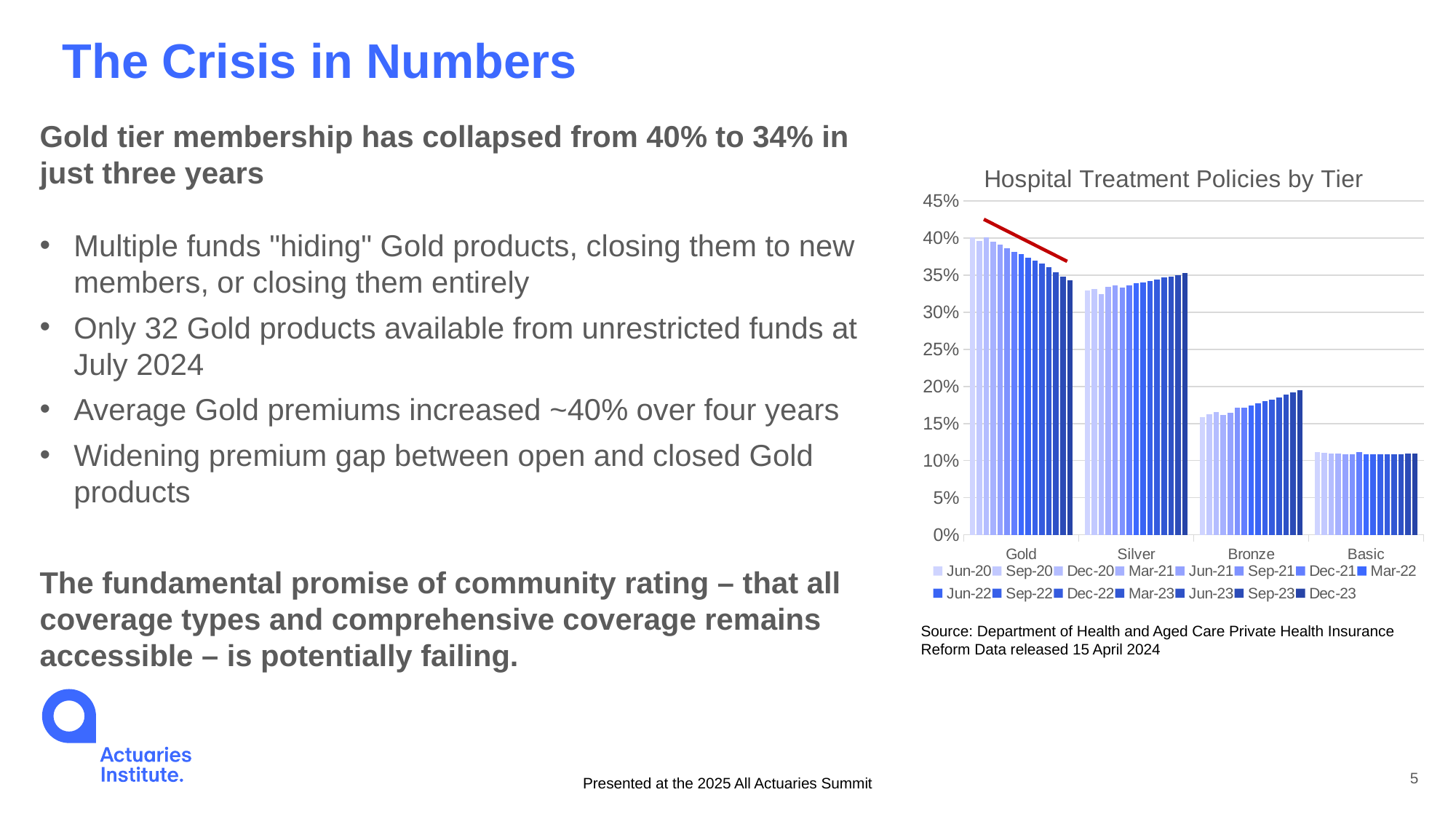
Which tier has the lowest share of hospital treatment policies in the chart? Basic Is the Gold tier value for Dec-23 greater or less than 40%? less How many tier categories are shown on the x axis of the chart? 4 Which is larger in Jun-20: the Gold tier value or the Silver tier value? Gold What is the title of the chart? Hospital Treatment Policies by Tier Is the Basic tier value for Dec-23 greater or less than 15%? less Is the Silver tier value for Dec-23 greater or less than 30%? greater Do the Bronze tier bars rise or fall from Jun-20 to Dec-23? Rise Which tier has the highest share of hospital treatment policies in the chart? Gold How many series does the chart's legend list? 15 Do the Gold tier bars rise or fall from Jun-20 to Dec-23? Fall What kind of chart is shown on the slide? Bar chart